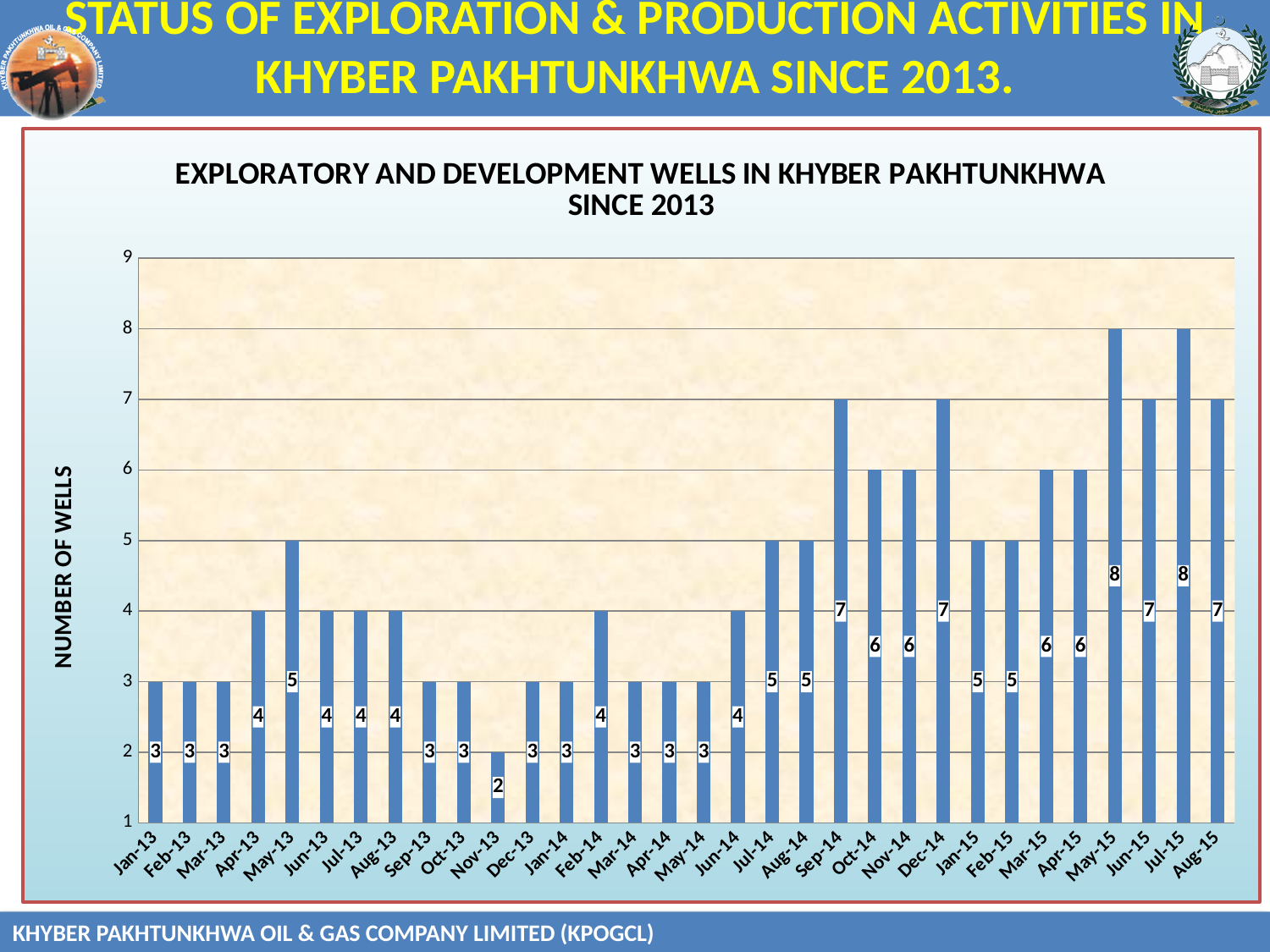
Which month has the lowest number of wells? Nov-13 Which two months reach the highest value of 8 wells? May-15 and Jul-15 What is the difference between the number of wells in Aug-15 and Jan-13? 4 Overall, do the number of wells rise or fall from Jan-13 to Aug-15? Rise How many wells are shown for Nov-13? 2 How many months are plotted on the x axis? 32 Which month has more wells, Dec-14 or Oct-14? Dec-14 What is the number of wells for Sep-14? 7 What is the highest number of wells shown in any month? 8 What is the label on the vertical axis of the chart? NUMBER OF WELLS What value is shown for Jul-14? 5 What type of chart is shown on the slide? Bar chart